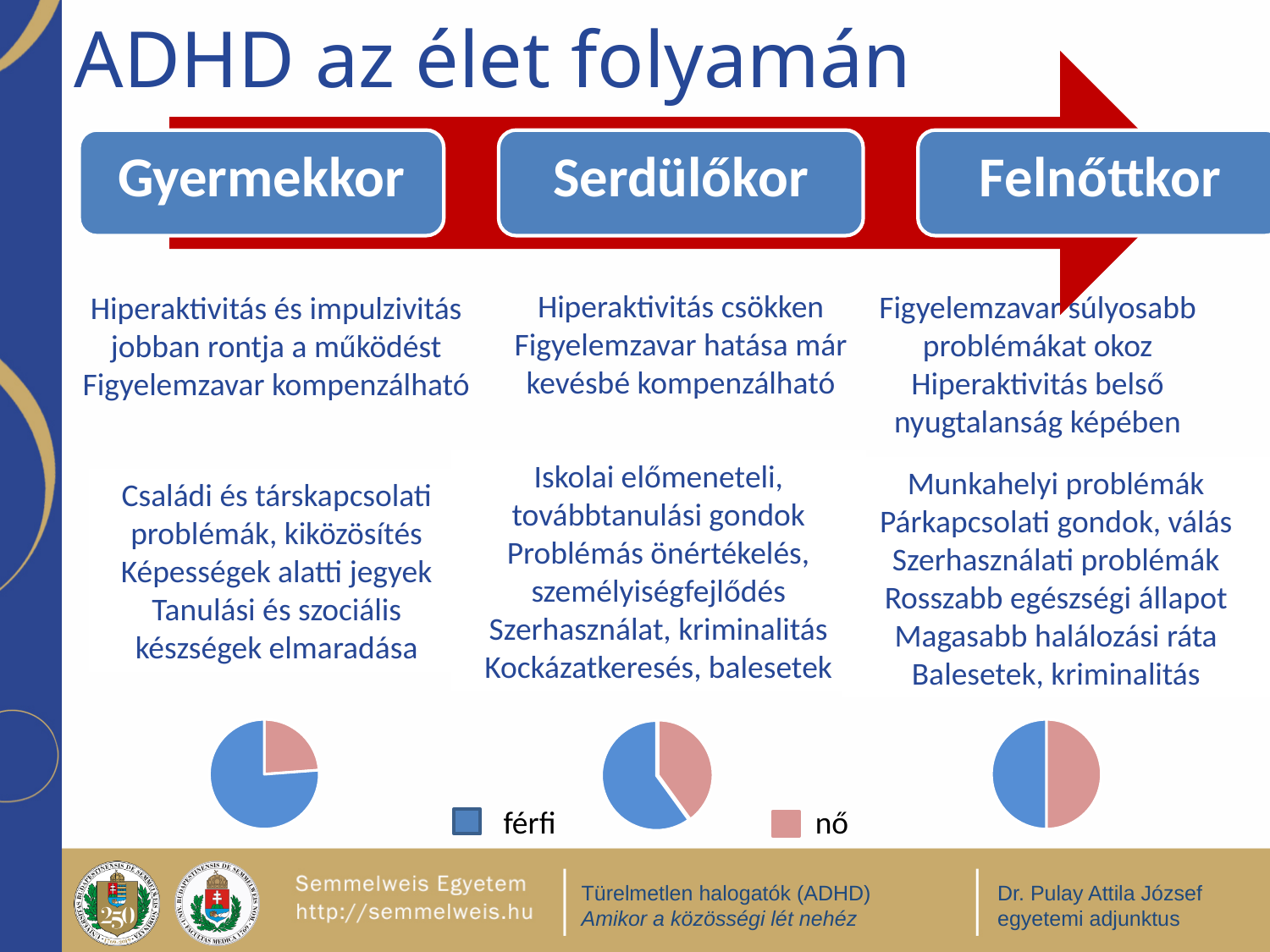
How many pie charts are shown on the slide? 3 In the pie chart under Gyermekkor, which slice is larger, férfi or nő? férfi In the pie chart under Serdülőkor, which category has the largest slice? férfi In the pie chart under Gyermekkor, which category has the smallest slice? nő Which colour represents férfi in the pie charts? blue How many slices does each pie chart on the slide have? 2 In the pie chart under Serdülőkor, which slice is larger, férfi or nő? férfi Which colour represents nő in the pie charts? pink How many series does the legend list for the pie charts? 2 What kind of chart is shown under the Gyermekkor column at the bottom of the slide? pie chart